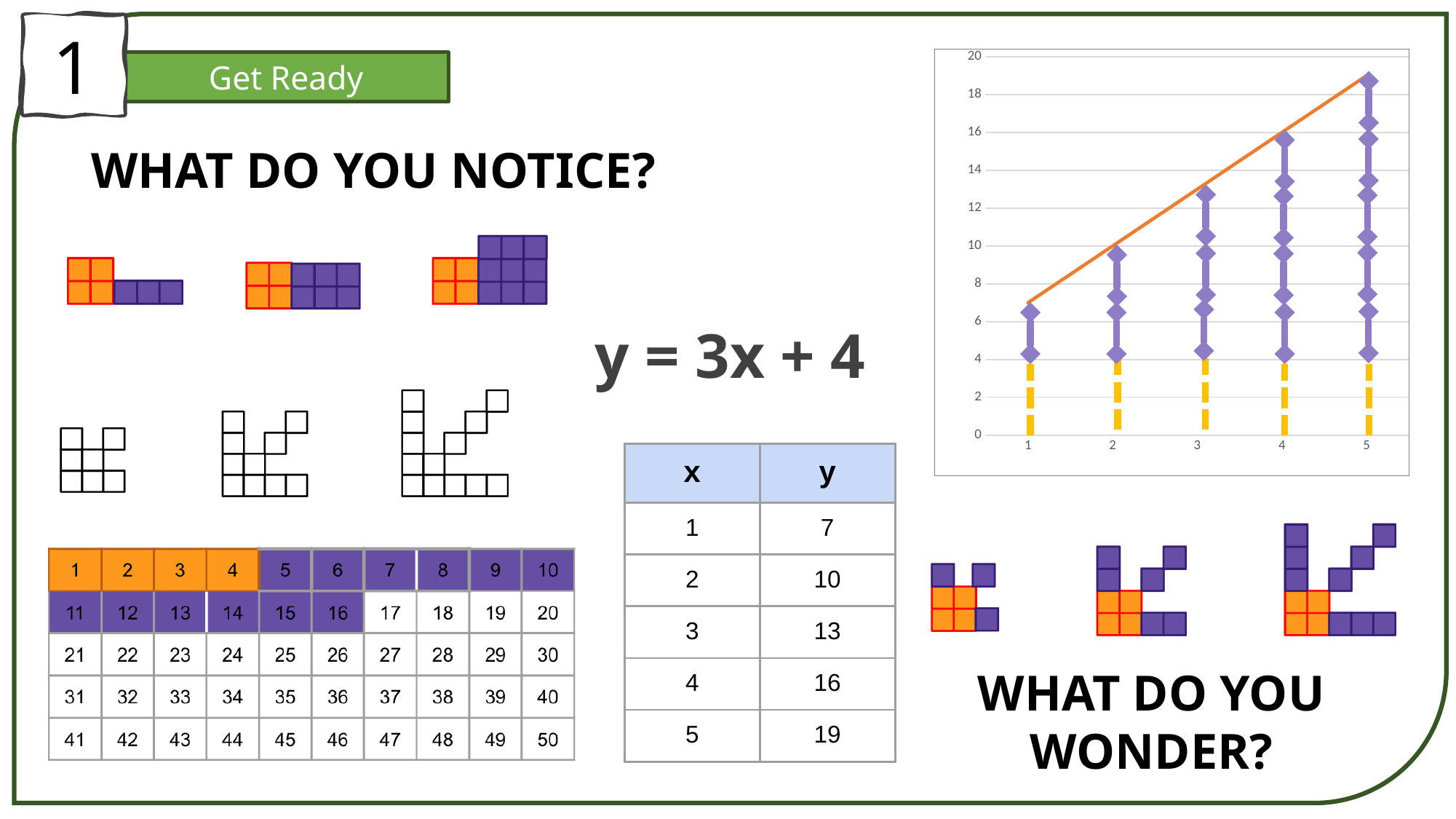
In the top-right chart, is the highest point at x = 3 greater or less than 12? greater In the top-right chart, at which x value does the highest point occur? 5 What kind of chart is shown in the top right of the slide? line chart In the top-right chart, what is the maximum value shown on the y axis? 20 In the top-right chart, is the highest point at x = 1 greater or less than 8? less In the top-right chart, what colour is the straight line connecting the topmost points? orange In the top-right chart, how many x-axis categories are plotted? 5 In the top-right chart, is the highest point at x = 2 greater or less than 12? less In the top-right chart, which has a higher topmost point: x = 4 or x = 2? x = 4 In the top-right chart, at which x value does the topmost point sit lowest? 1 In the top-right chart, do the topmost points rise or fall as x increases from 1 to 5? rise